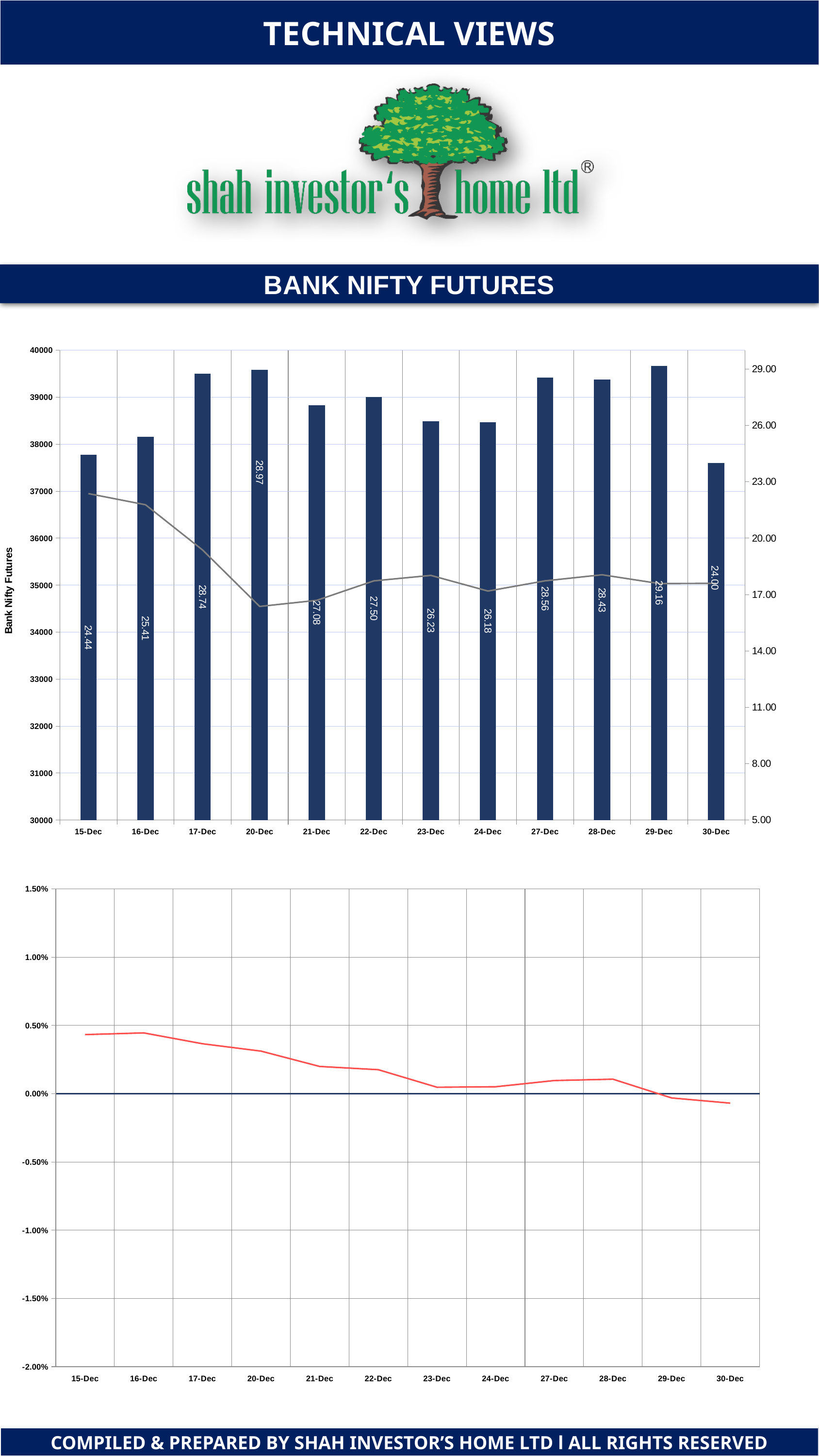
In the top chart, is the bar for 15-Dec greater or less than 38000 on the left axis? less In the top chart, is the bar for 17-Dec greater or less than 39000 on the left axis? greater What is the label of the left vertical axis of the top chart? Bank Nifty Futures In the top chart, does the grey line rise or fall from 15-Dec to 20-Dec? fall In the top chart, is the bar for 23-Dec higher or lower than the bar for 27-Dec? 27-Dec is higher How many dates are shown on the x axis of the top chart? 12 In the top chart, which date has the lowest bar? 30-Dec In the top chart, what data label is printed on the bar for 29-Dec? 29.16 In the top chart, what data label is printed on the bar for 30-Dec? 24.00 In the bottom chart, is the value for 15-Dec greater or less than 0.00%? greater In the bottom chart, does the red line generally rise or fall from 15-Dec to 30-Dec? fall In the top chart, what data label is printed on the bar for 15-Dec? 24.44